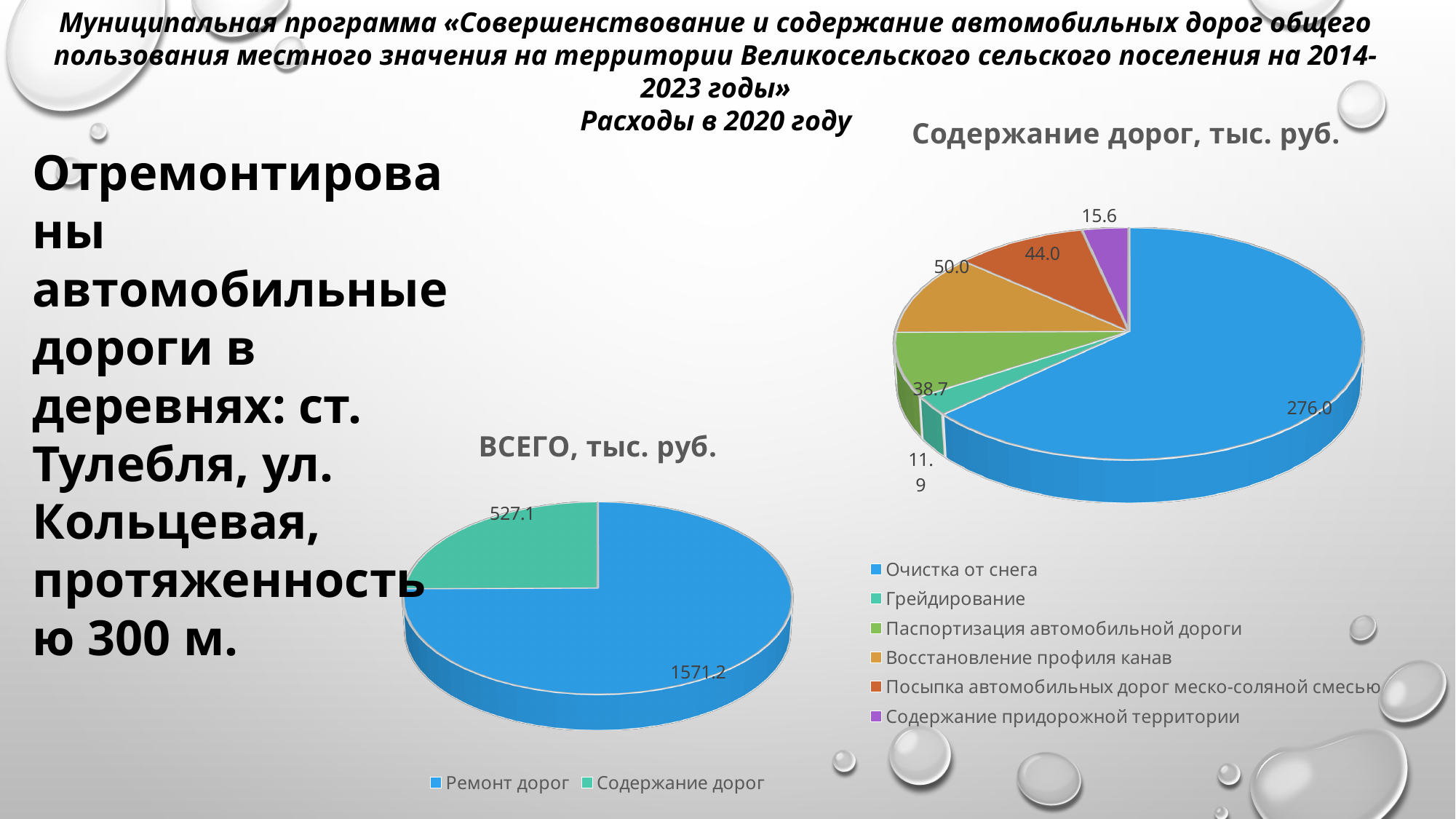
In the chart titled "Содержание дорог, тыс. руб.", what is the value for Грейдирование? 11.9 What kind of chart is the chart titled "Содержание дорог, тыс. руб."? Pie chart In the chart titled "Содержание дорог, тыс. руб.", how many categories are shown? 6 In the chart titled "ВСЕГО, тыс. руб.", what is the difference between Ремонт дорог and Содержание дорог? 1044.1 In the chart titled "Содержание дорог, тыс. руб.", which category has the smallest value? Грейдирование In the chart titled "Содержание дорог, тыс. руб.", what is the value for Восстановление профиля канав? 50.0 In the chart titled "ВСЕГО, тыс. руб.", what is the value for Ремонт дорог? 1571.2 In the chart titled "Содержание дорог, тыс. руб.", which category has the largest value? Очистка от снега In the chart titled "Содержание дорог, тыс. руб.", what is the value for Очистка от снега? 276.0 In the chart titled "Содержание дорог, тыс. руб.", which is larger: Посыпка автомобильных дорог меско-соляной смесью or Паспортизация автомобильной дороги? Посыпка автомобильных дорог меско-соляной смесью In the chart titled "ВСЕГО, тыс. руб.", what is the value for Содержание дорог? 527.1 In the chart titled "ВСЕГО, тыс. руб.", how many categories does the legend list? 2